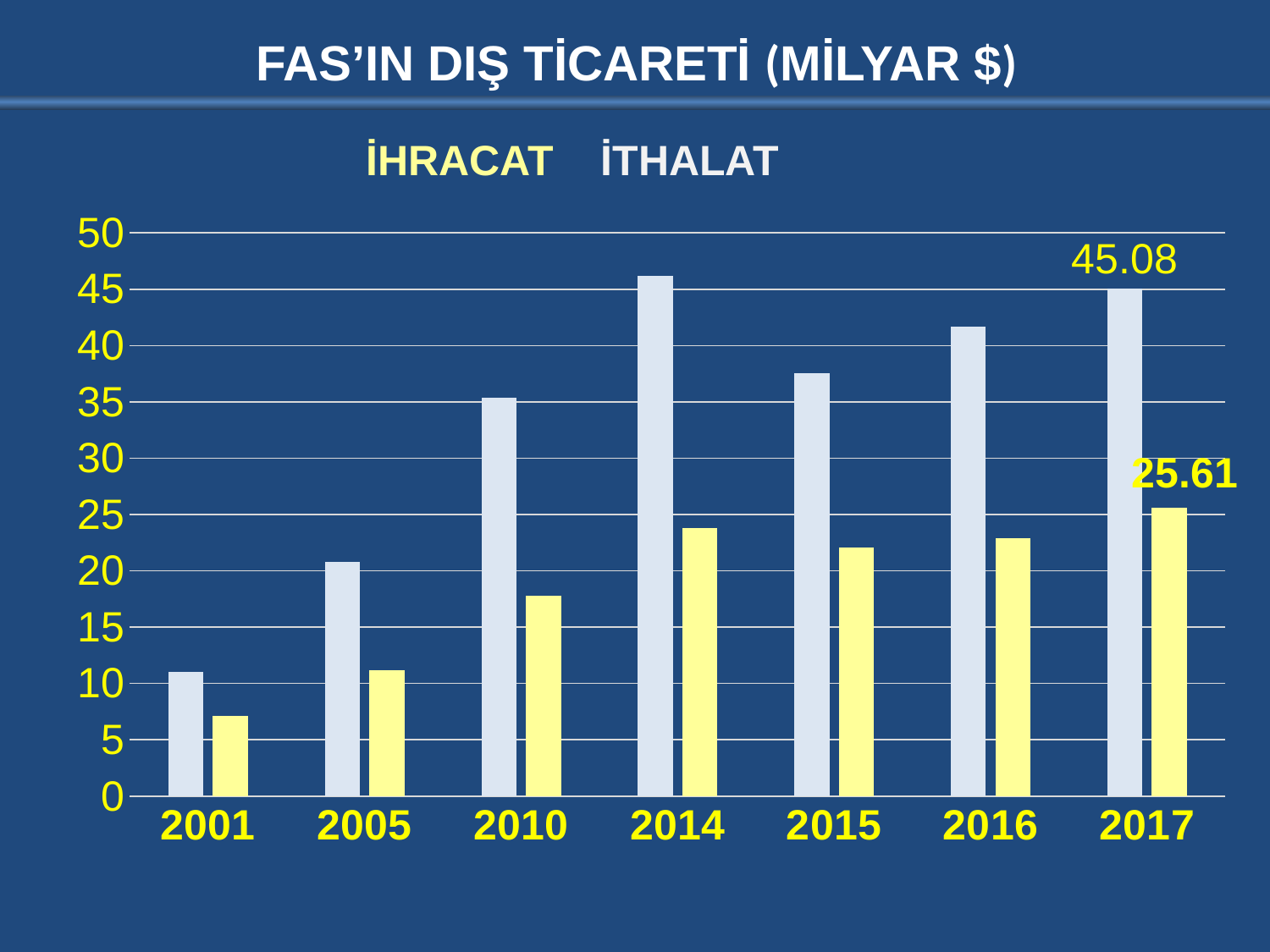
What is the difference between the İTHALAT and İHRACAT values for 2017? 19.47 How many series does the legend list? 2 In which year is the İTHALAT value lowest? 2001 How many years are shown on the x axis? 7 In which year is the İHRACAT value highest? 2017 Does the İHRACAT value rise or fall from 2001 to 2017? rise What is the İHRACAT value for 2017? 25.61 Which is larger in 2016, İHRACAT or İTHALAT? İTHALAT What is the İTHALAT value for 2017? 45.08 Is the İTHALAT value for 2015 greater or less than 35? greater Is the İHRACAT value for 2014 greater or less than 25? less Is the İHRACAT value for 2001 greater or less than 10? less